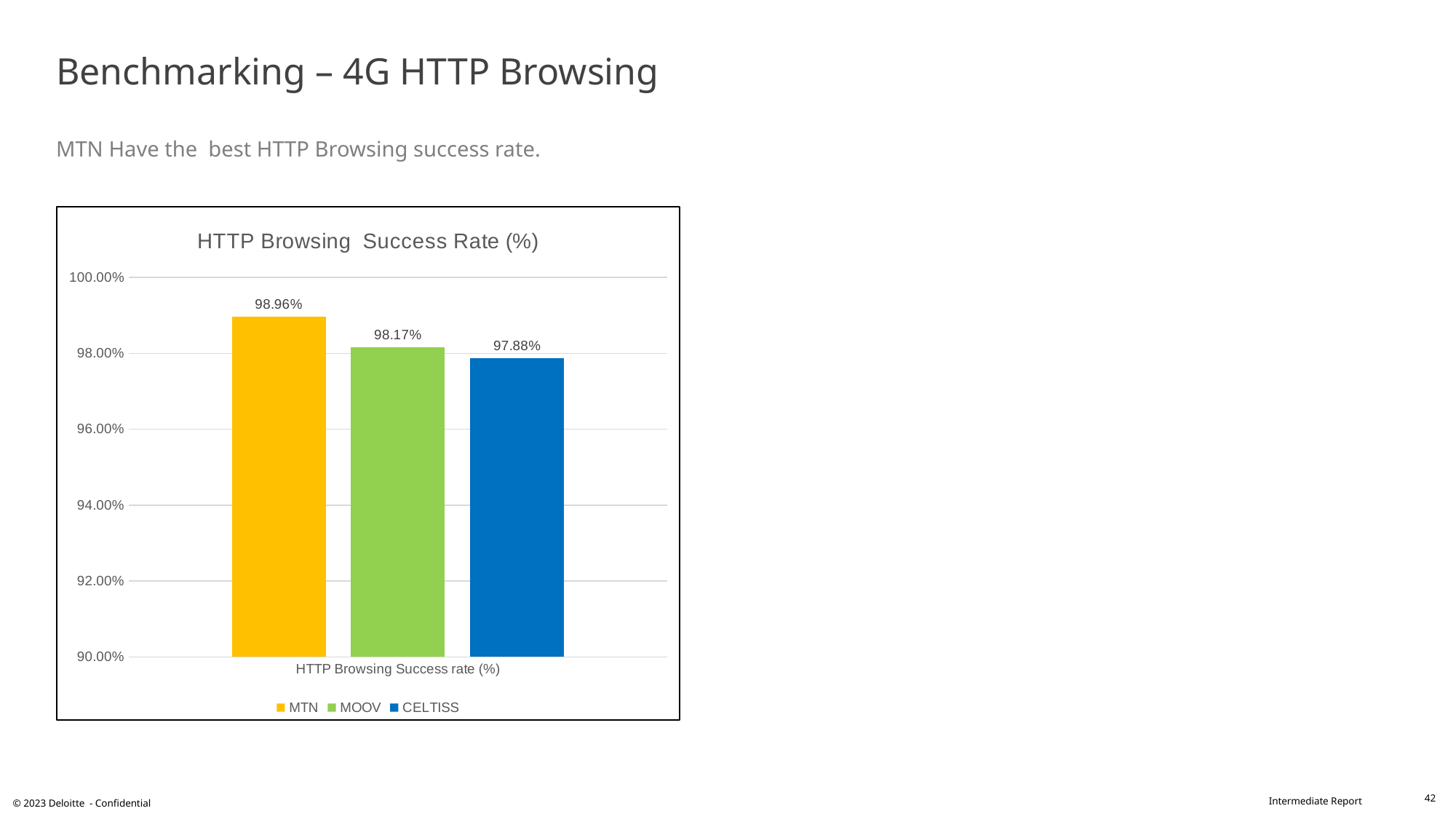
Which has a higher HTTP Browsing success rate, MOOV or CELTISS? MOOV What is the difference between MTN's and MOOV's HTTP Browsing success rates? 0.79% What is the difference between MTN's and CELTISS's HTTP Browsing success rates? 1.08% What is the HTTP Browsing success rate for CELTISS? 97.88% Is the value for CELTISS greater or less than 98.00%? less What is the title of the chart? HTTP Browsing Success Rate (%) What is the HTTP Browsing success rate for MOOV? 98.17% What is the HTTP Browsing success rate for MTN? 98.96% Which operator has the highest HTTP Browsing success rate? MTN Which operator has the lowest HTTP Browsing success rate? CELTISS What kind of chart is shown on the slide? Bar chart How many series does the legend list? 3